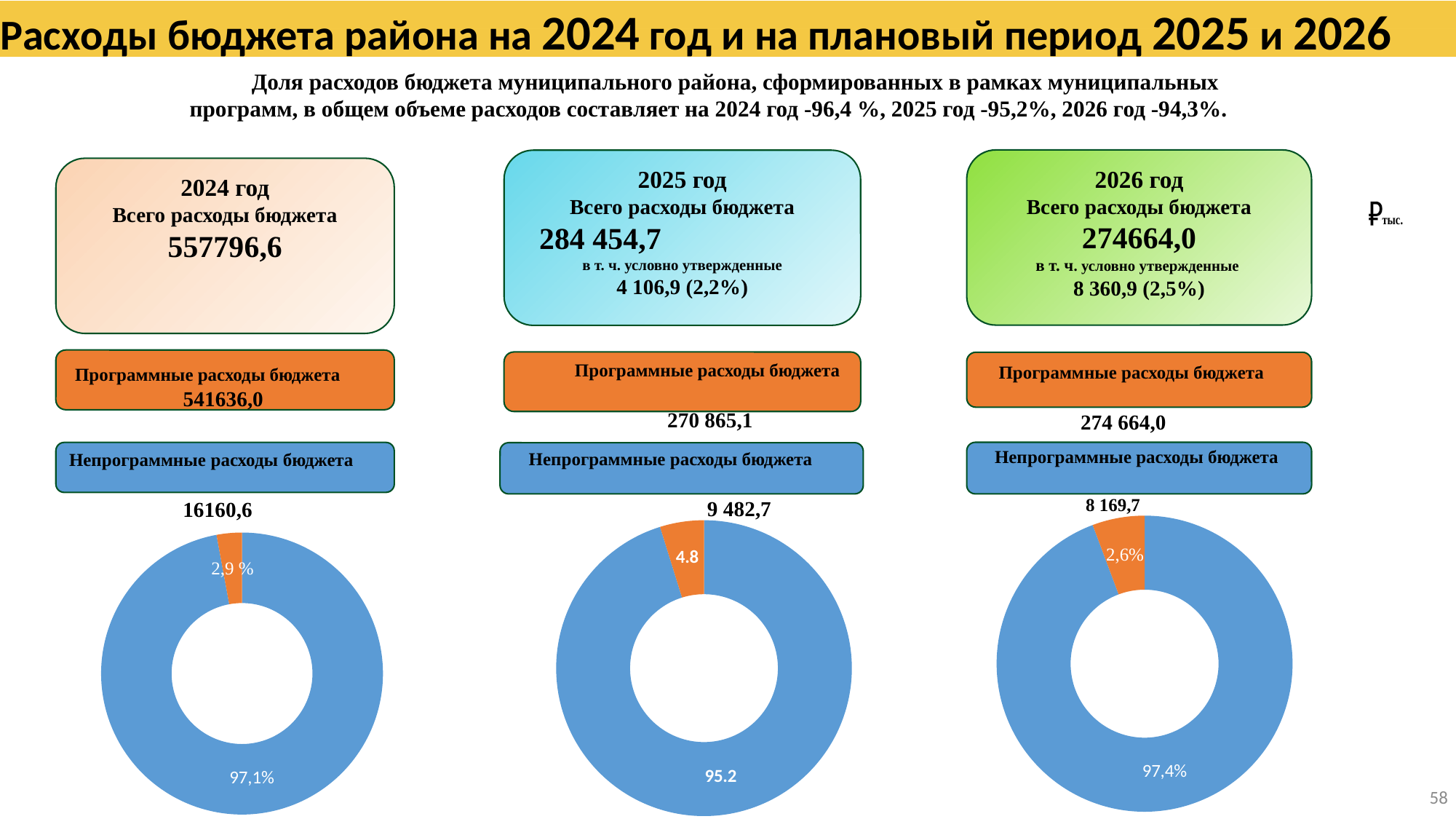
What colour is the largest slice in each of the three doughnut charts? Blue How many slices does the middle doughnut chart (under 2025) have? 2 In the right doughnut chart (2026), what is the label on the blue slice? 97,4% In the right doughnut chart (2026), which slice is the largest? The blue slice (97,4%) In the middle doughnut chart (2025), what is the label on the blue slice? 95.2 In the middle doughnut chart (2025), what is the label on the orange slice? 4.8 In the left doughnut chart (2024), what is the label on the orange slice? 2,9 % In the right doughnut chart (2026), what is the label on the orange slice? 2,6% In the middle doughnut chart (2025), which slice is the smallest? The orange slice (4.8) What kind of chart is the left chart under the 2024 box? Doughnut chart Which orange slice is larger: the one in the middle doughnut chart (2025) or the one in the left doughnut chart (2024)? The middle chart (2025) In the left doughnut chart (2024), what is the label on the blue slice? 97,1%